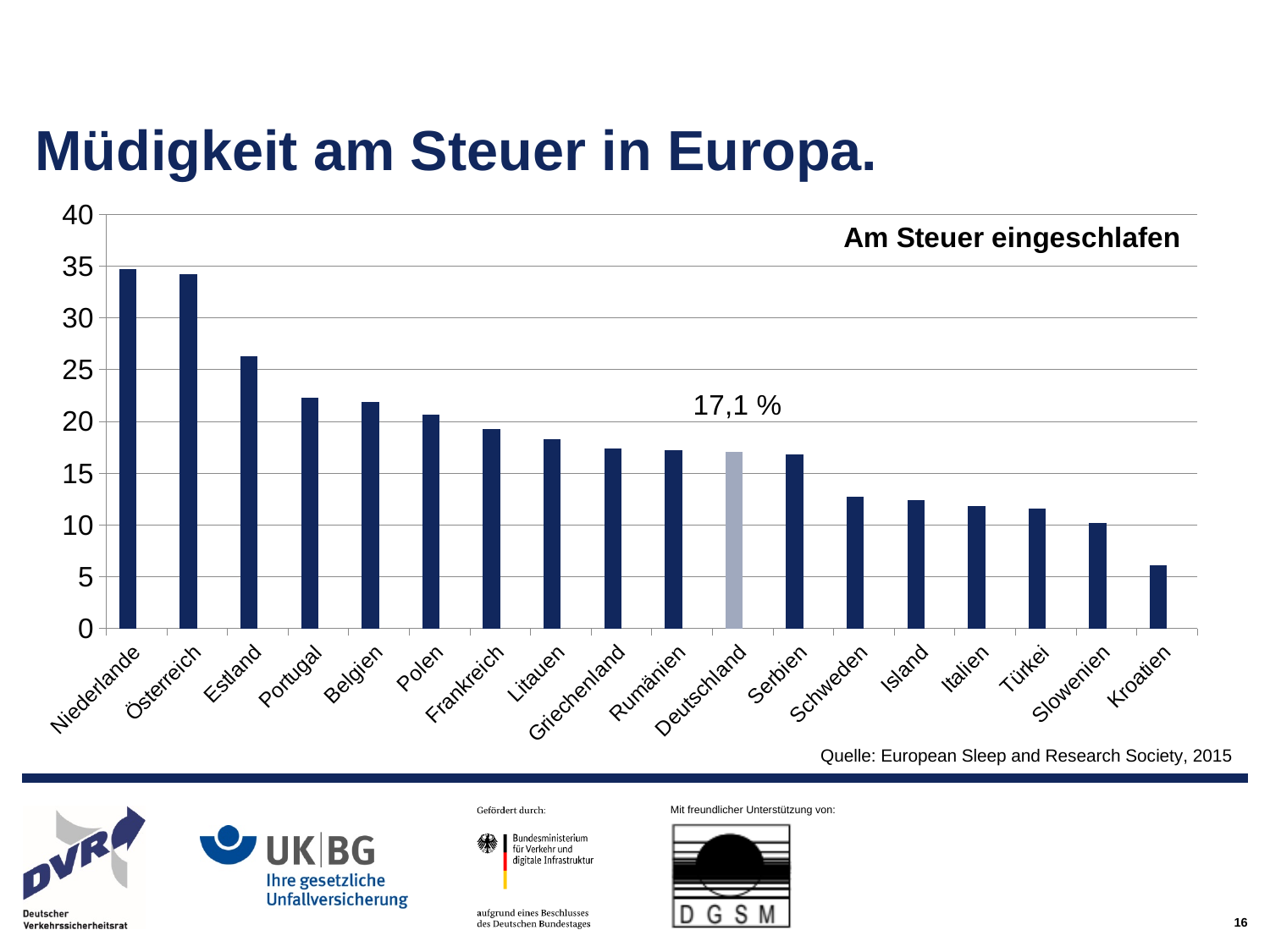
What kind of chart is shown on the slide? bar chart Which has the larger value, Slowenien or Kroatien? Slowenien Is the value for Kroatien greater or less than 10? less Is the value for Estland greater or less than 25? greater Do the values rise or fall from left to right along the x axis? fall Which country has the lowest bar in the chart? Kroatien Which country's bar is drawn in a different (lighter) colour from the others? Deutschland What value is labelled on the bar for Deutschland? 17,1 % Is the value for Niederlande greater or less than 30? greater How many countries are shown on the x axis? 18 Which has the larger value, Estland or Portugal? Estland